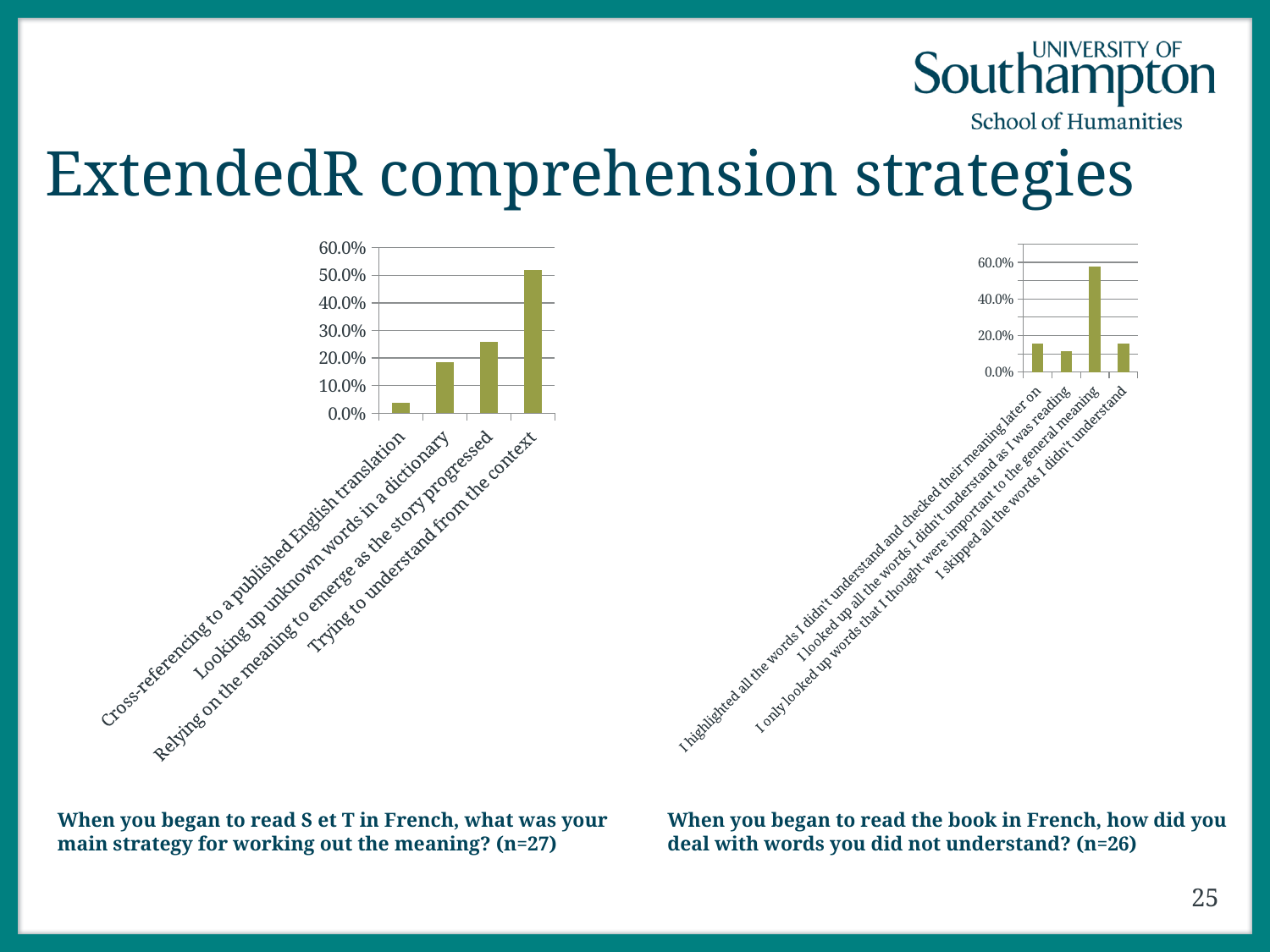
What kind of chart is the left chart on the slide? bar chart In the left chart, which strategy has the highest value? Trying to understand from the context In the left chart, is the value for 'Cross-referencing to a published English translation' greater or less than 10.0%? less How many categories are shown in the right chart (how did you deal with words you did not understand)? 4 In the left chart, which is larger: 'Relying on the meaning to emerge as the story progressed' or 'Looking up unknown words in a dictionary'? Relying on the meaning to emerge as the story progressed In the right chart, is the value for 'I skipped all the words I didn't understand' greater or less than 20.0%? less In the right chart, which response has the highest value? I only looked up words that I thought were important to the general meaning In the right chart, which response has the lowest value? I looked up all the words I didn't understand as I was reading How many categories are shown in the left chart (main strategy for working out the meaning)? 4 In the left chart, is the value for 'Trying to understand from the context' greater or less than 40.0%? greater In the left chart, do the values rise or fall from left to right along the x axis? rise In the left chart, which strategy has the lowest value? Cross-referencing to a published English translation